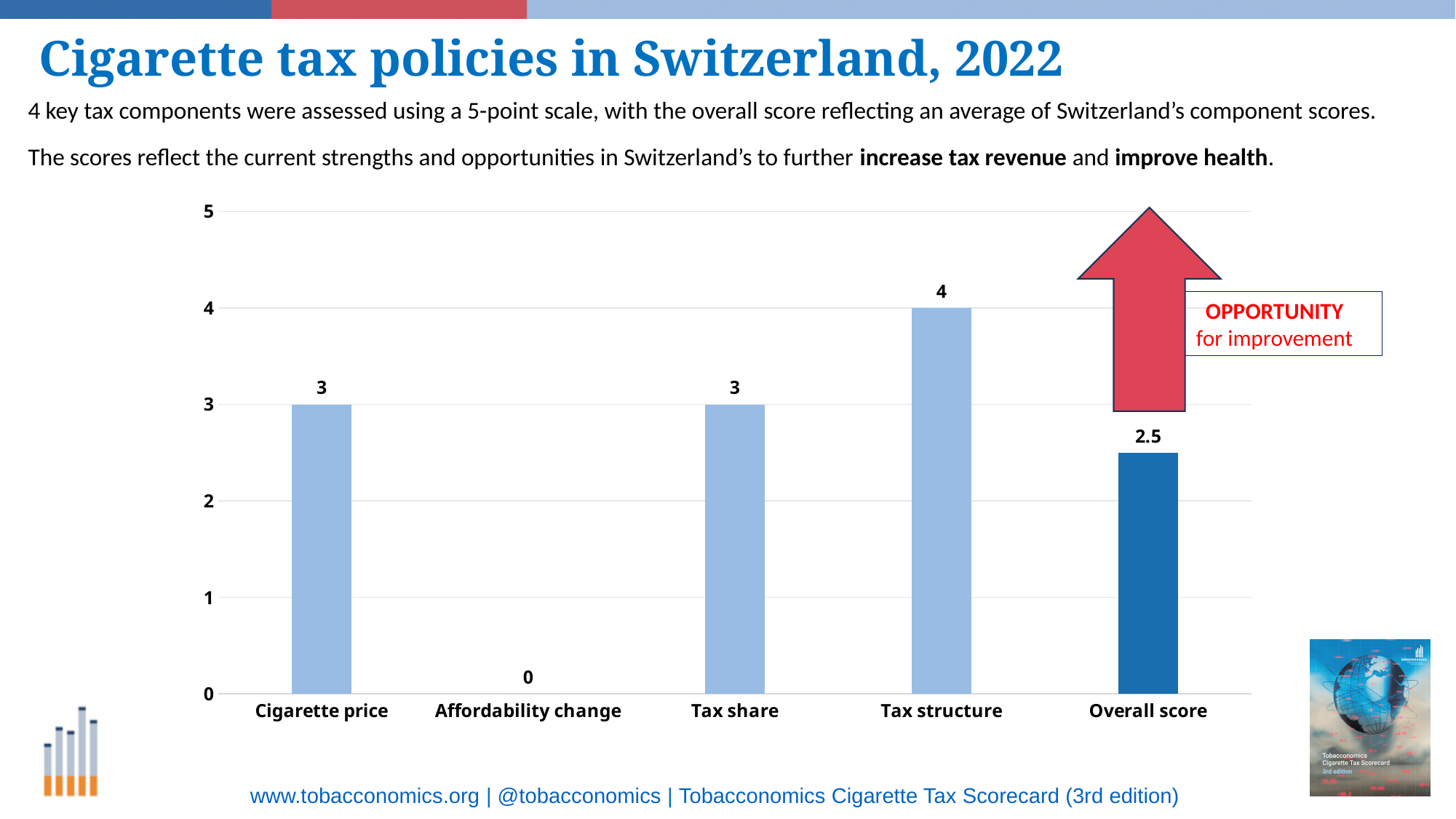
What is the score for Affordability change? 0 What is the maximum value shown on the y axis of the chart? 5 Which category has the highest score? Tax structure Which category has the lowest score? Affordability change Is the Overall score greater or less than 3? less Which is larger, the score for Tax share or the score for Tax structure? Tax structure What is the Overall score shown on the chart? 2.5 What is the score for Tax structure? 4 How many categories are shown on the x axis of the chart? 5 What is the difference between the Tax structure score and the Overall score? 1.5 What kind of chart is shown on the slide? bar chart What is the score for Cigarette price? 3